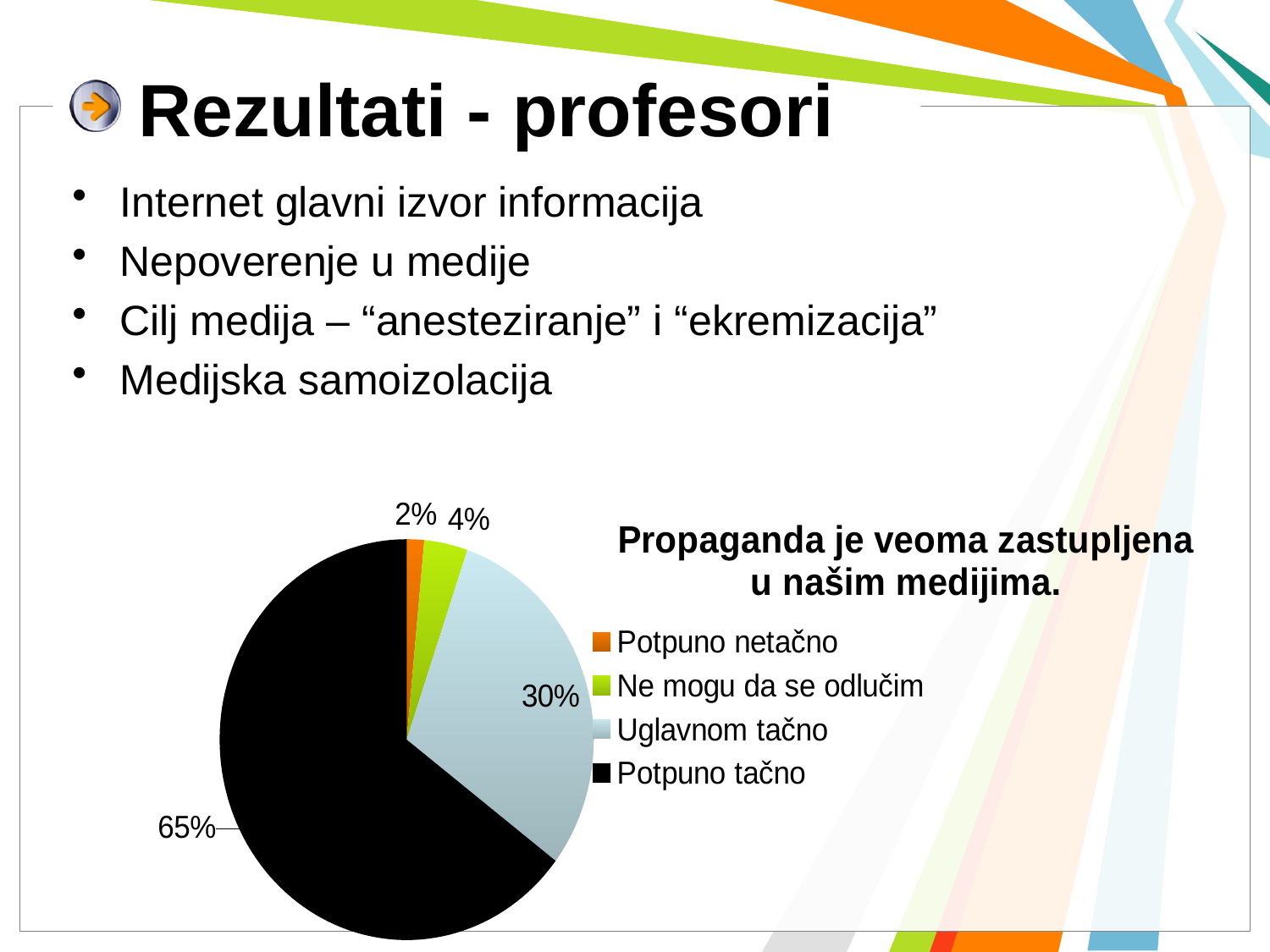
What is the chart's title? Propaganda je veoma zastupljena u našim medijima. Which category has the largest slice of the pie? Potpuno tačno What colour is the slice for "Potpuno tačno"? black Which category has the smallest slice of the pie? Potpuno netačno What percentage of the pie is labelled "Potpuno tačno"? 65% What kind of chart is shown on the slide? pie chart Which is larger, the slice for "Ne mogu da se odlučim" or the slice for "Potpuno netačno"? Ne mogu da se odlučim How many categories does the pie chart's legend list? 4 What percentage of the pie is labelled "Uglavnom tačno"? 30% What is the difference in percentage points between "Potpuno tačno" and "Uglavnom tačno"? 35 What percentage of the pie is labelled "Ne mogu da se odlučim"? 4% What percentage of the pie is labelled "Potpuno netačno"? 2%